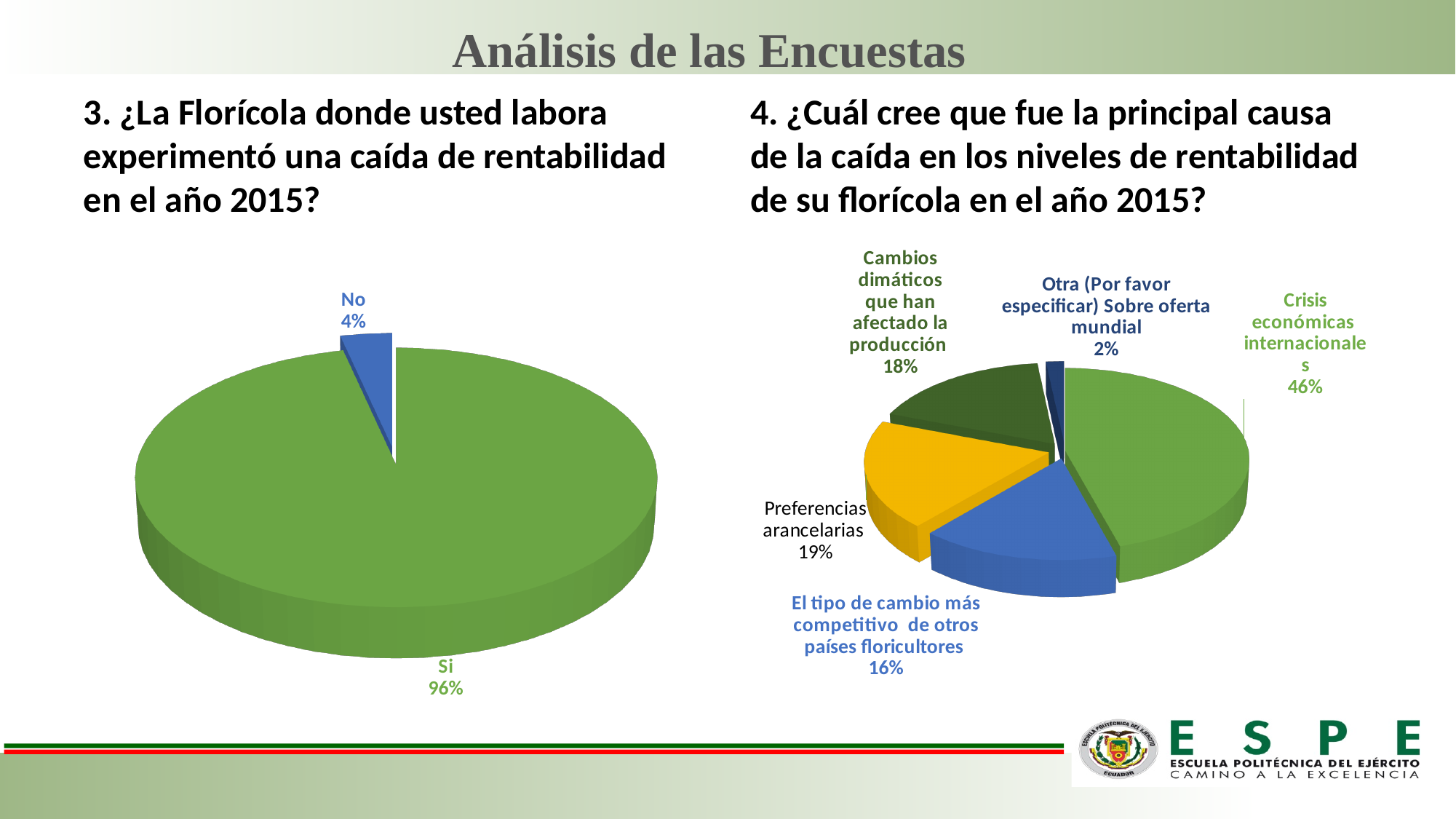
In the left pie chart (question 3), what share of respondents answered "Si"? 96% In the right pie chart (question 4), which is larger: the share for "Preferencias arancelarias" or the share for "El tipo de cambio más competitivo de otros países floricultores"? Preferencias arancelarias In the left pie chart (question 3), how many slices does the pie have? 2 In the right pie chart (question 4), what is the difference between the share for "Crisis económicas internacionales" and the share for "El tipo de cambio más competitivo de otros países floricultores"? 30% In the right pie chart (question 4), which category has the largest share? Crisis económicas internacionales What kind of chart is used for question 3 on the left? Pie chart In the right pie chart (question 4), what share is labelled "Crisis económicas internacionales"? 46% In the right pie chart (question 4), which category has the smallest share? Otra (Por favor especificar) Sobre oferta mundial In the right pie chart (question 4), how many categories are shown? 5 In the left pie chart (question 3), what share of respondents answered "No"? 4% In the right pie chart (question 4), what share is labelled "Cambios climáticos que han afectado la producción"? 18% In the right pie chart (question 4), what share is labelled "Preferencias arancelarias"? 19%